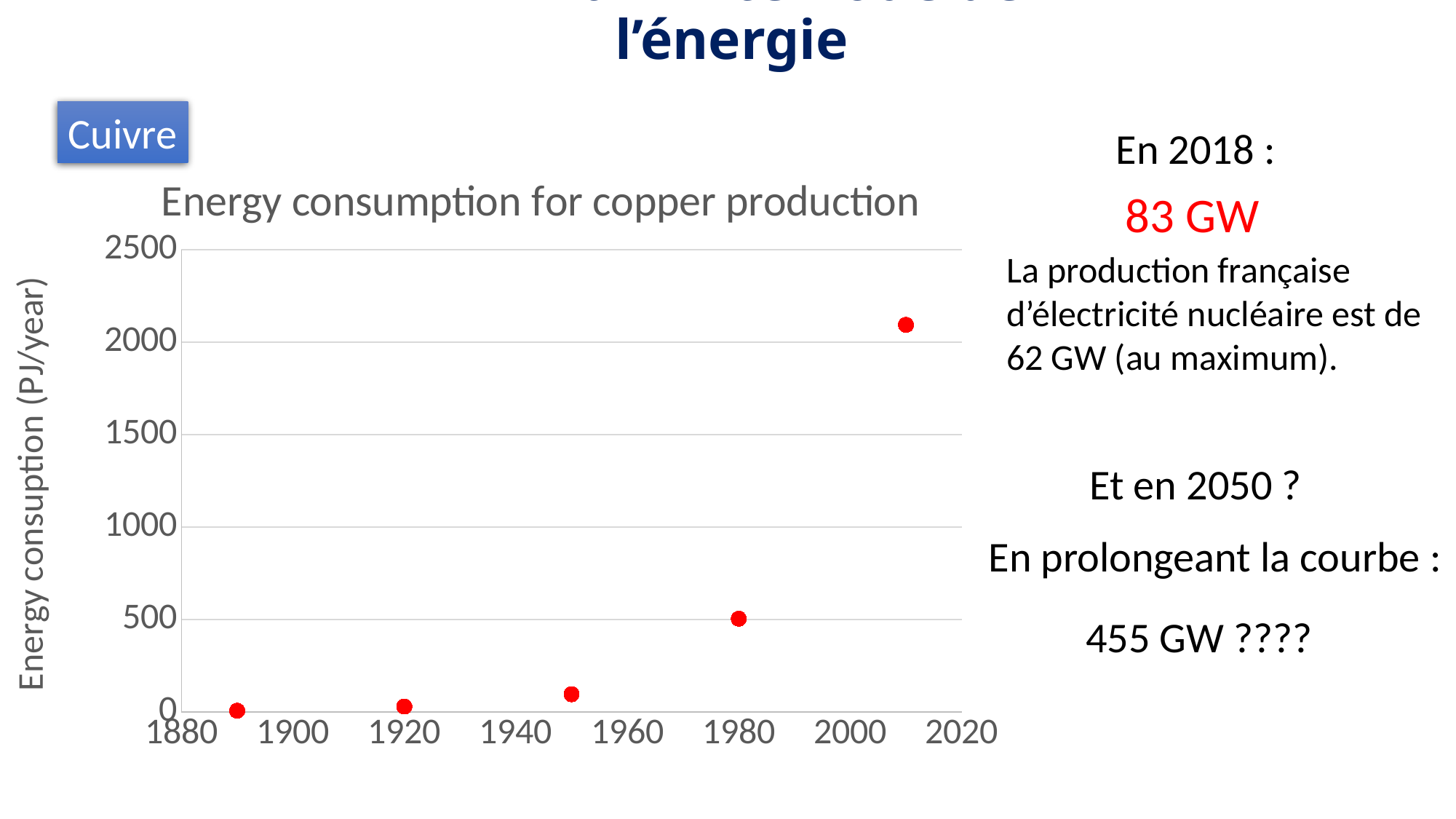
Which has the larger energy consumption, the point around 1980 or the point around 2010? 2010 Do the plotted values rise or fall as the years increase along the x axis? rise Is the energy consumption for the point around 1980 greater or less than 1000? less Which year has the highest energy consumption on the chart? 2010 What kind of chart is shown on the slide? scatter chart How many data points are plotted on the chart? 5 Is the energy consumption for the point around 2010 greater or less than 2000? greater Is the energy consumption for the point around 1950 greater or less than 500? less Which has the larger energy consumption, the point around 1950 or the point around 1980? 1980 What is the title of the chart? Energy consumption for copper production What is the label of the vertical axis of the chart? Energy consuption (PJ/year)